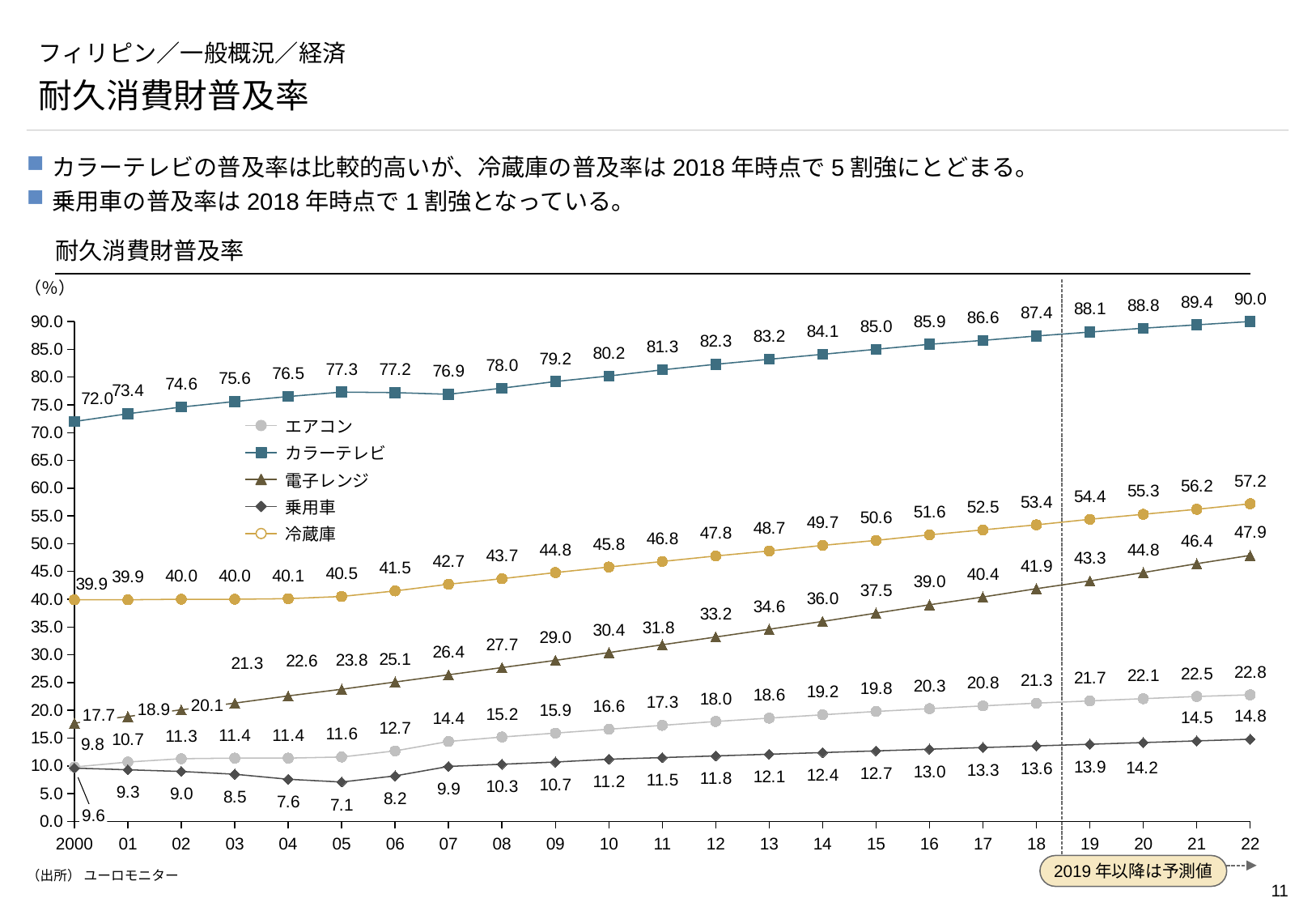
How many series does the legend list? 5 What is the value for 電子レンジ in 2010? 30.4 Does the value for 冷蔵庫 rise or fall from 2005 to 2022? rise What kind of chart is shown on the slide? line chart In which year is the value for 乗用車 lowest? 05 Which series has the highest value in 2022? カラーテレビ What is the difference between the カラーテレビ value in 2022 and in 2000? 18.0 Which is larger in 2018, the value for エアコン or the value for 乗用車? エアコン What is the unit shown on the y axis of the chart? % What is the value for 冷蔵庫 in 2022? 57.2 What is the value for 乗用車 in 2005? 7.1 What is the value for カラーテレビ in 2018? 87.4